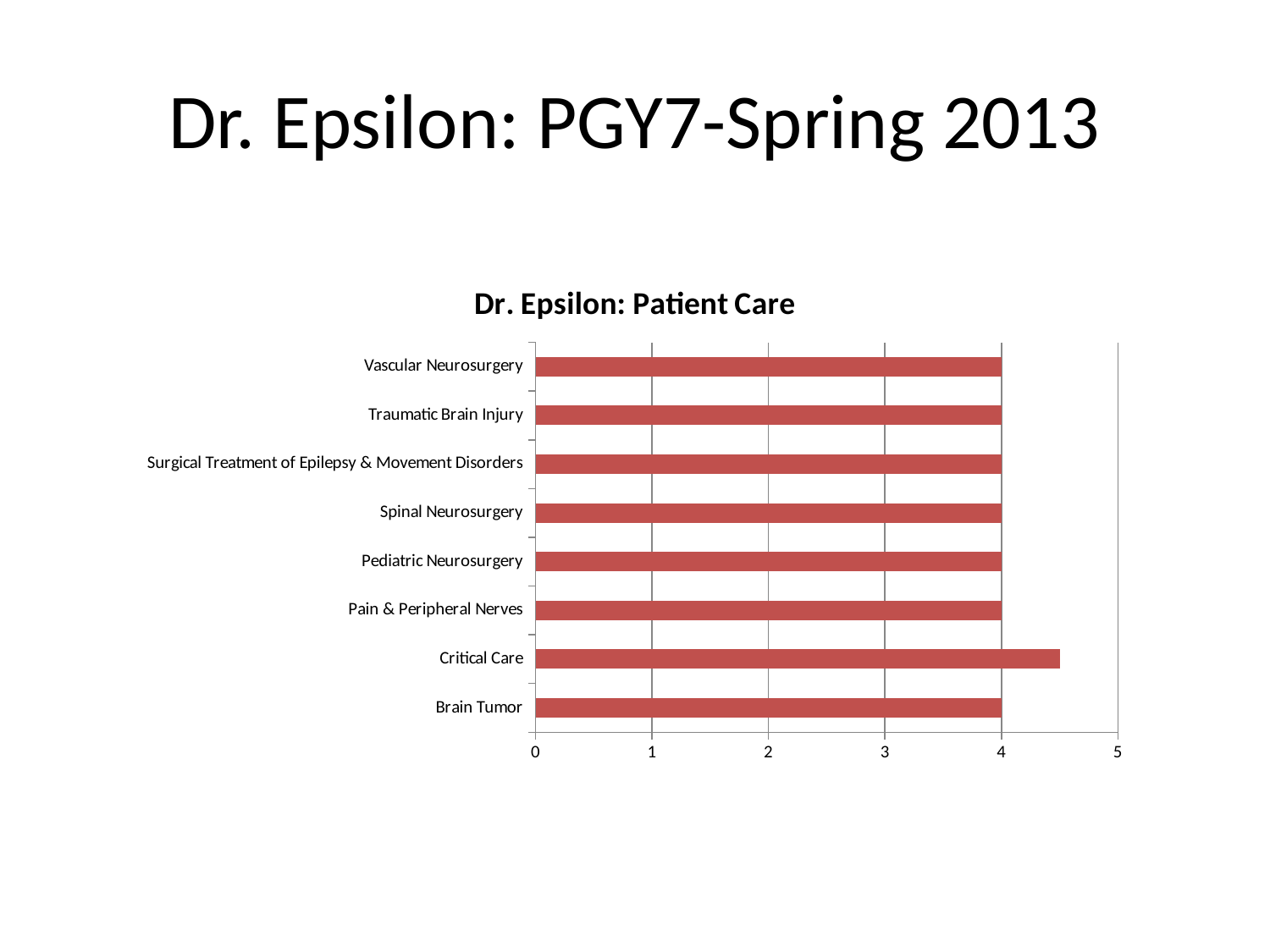
What is the value for Vascular Neurosurgery? 4 What is the value for Spinal Neurosurgery? 4 What is the title of the chart? Dr. Epsilon: Patient Care Which category has the highest value in the chart? Critical Care How many categories are plotted in the chart? 8 What is the value for Brain Tumor? 4 Is the value for Critical Care greater or less than 4? greater Is the value for Critical Care greater or less than 5? less What type of chart is shown on the slide? bar chart Which is larger, the value for Critical Care or the value for Pain & Peripheral Nerves? Critical Care What is the highest value shown on the horizontal axis? 5 What is the value for Traumatic Brain Injury? 4